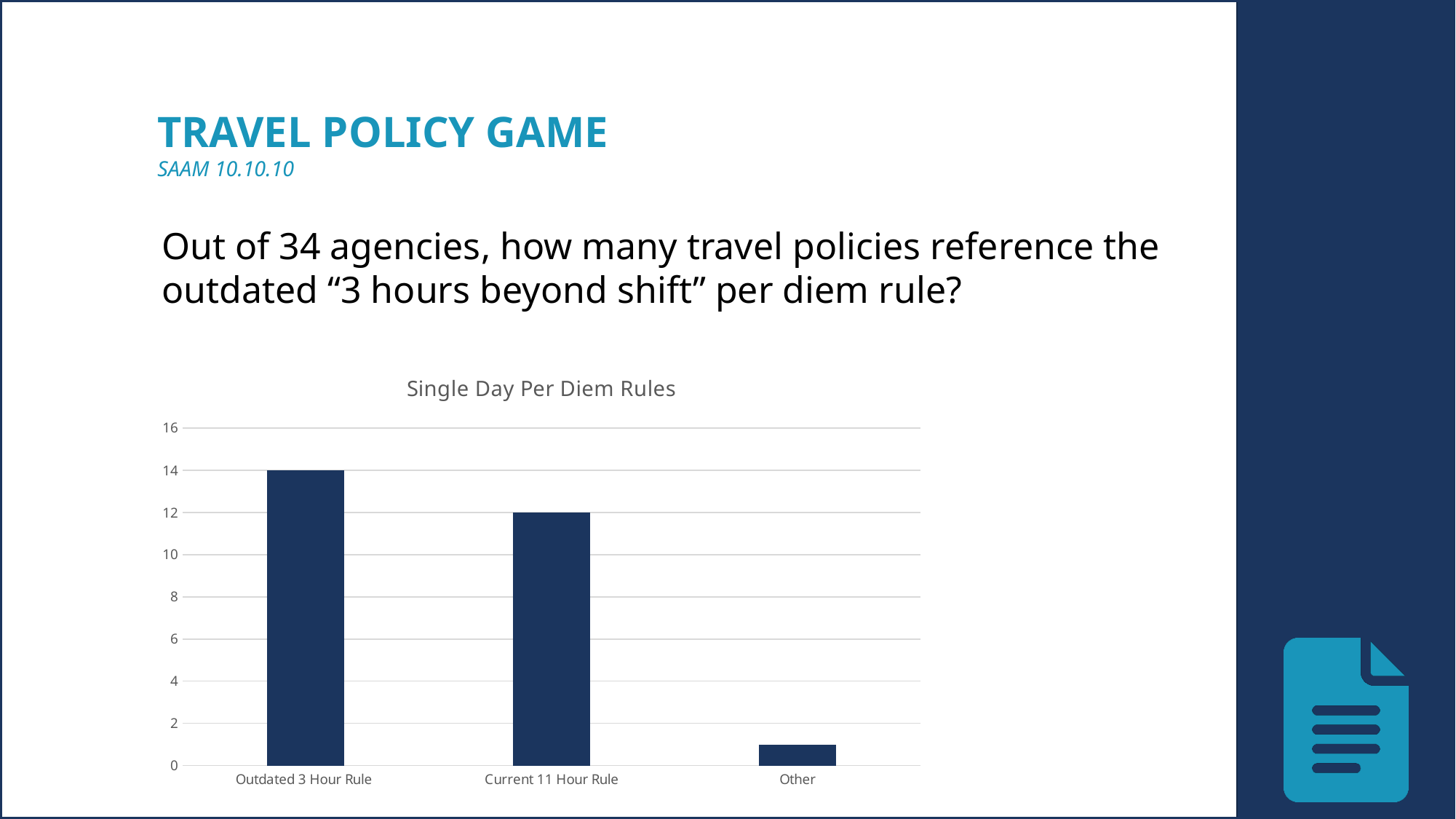
What kind of chart is shown on the slide? bar chart What is the title of the chart? Single Day Per Diem Rules Is the value for Outdated 3 Hour Rule greater or less than 10? greater Is the value for Other greater or less than 2? less Do the values rise or fall from left to right along the x axis? fall What is the value for Current 11 Hour Rule? 12 How many categories are shown on the x axis? 3 Which category has the highest value? Outdated 3 Hour Rule Which is larger, the value for Current 11 Hour Rule or the value for Other? Current 11 Hour Rule What is the value for Outdated 3 Hour Rule? 14 Which category has the lowest value? Other What is the difference between the values for Outdated 3 Hour Rule and Current 11 Hour Rule? 2